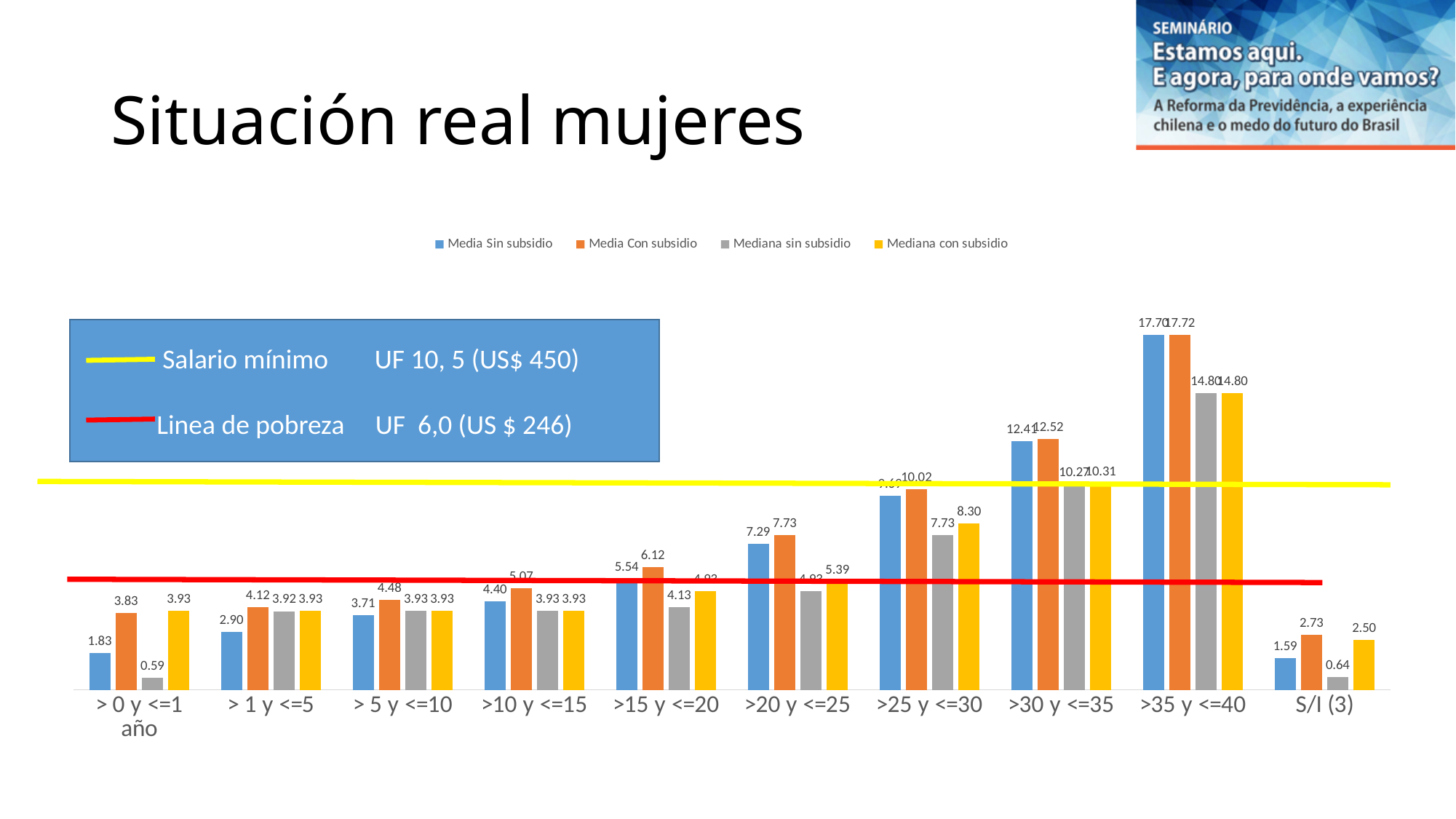
How many categories are shown on the x axis? 10 Does the Media Sin subsidio value rise or fall from > 0 y <=1 año to >35 y <=40? Rise What is the value of Media Con subsidio for the >35 y <=40 category? 17.72 Which is larger: Mediana con subsidio for >25 y <=30 or for >20 y <=25? >25 y <=30 What kind of chart is shown on the slide? Bar chart Which category has the highest Media Sin subsidio value? >35 y <=40 What is the value of Mediana con subsidio for the S/I (3) category? 2.50 How many series does the legend list? 4 What is the difference between Media Con subsidio and Media Sin subsidio for the >30 y <=35 category? 0.11 Which category has the lowest Mediana sin subsidio value? > 0 y <=1 año What is the value of Media Sin subsidio for the >30 y <=35 category? 12.41 What is the value of Mediana sin subsidio for the > 0 y <=1 año category? 0.59